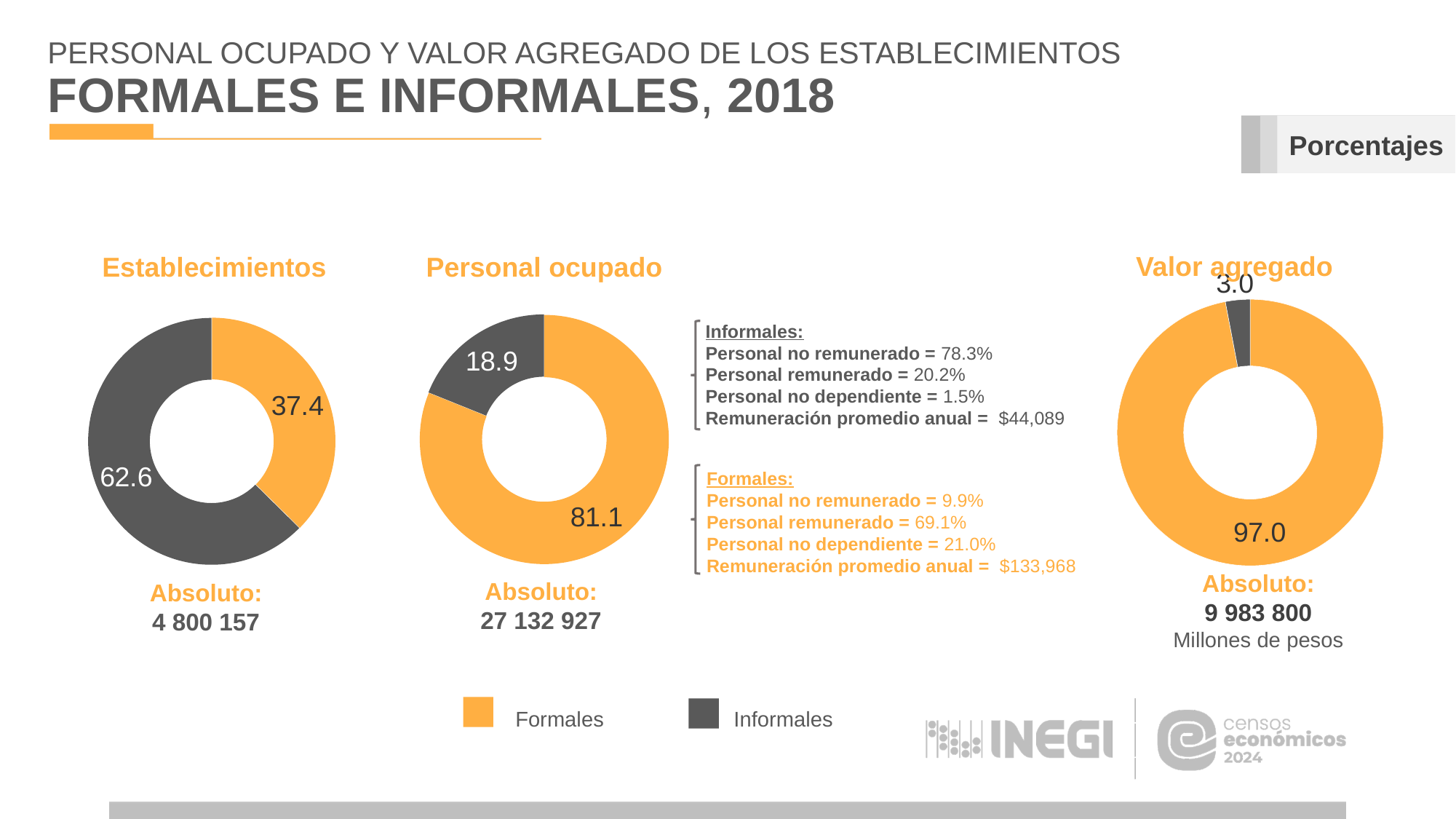
In the Valor agregado chart, which category has the smallest share? Informales In the Establecimientos chart, which category has the largest share? Informales In the Establecimientos chart, what is the value for Formales? 37.4 In the Establecimientos chart, what is the value for Informales? 62.6 In the Personal ocupado chart, what is the value for Informales? 18.9 Which colour represents Formales in the charts? Orange In the Valor agregado chart, what is the value for Formales? 97.0 What kind of chart is the Personal ocupado chart? Doughnut chart In the Establecimientos chart, which is larger, Formales or Informales? Informales What is the absolute value shown below the Personal ocupado chart? 27 132 927 How many categories does the legend list? 2 In the Personal ocupado chart, what is the difference between the Formales and Informales values? 62.2